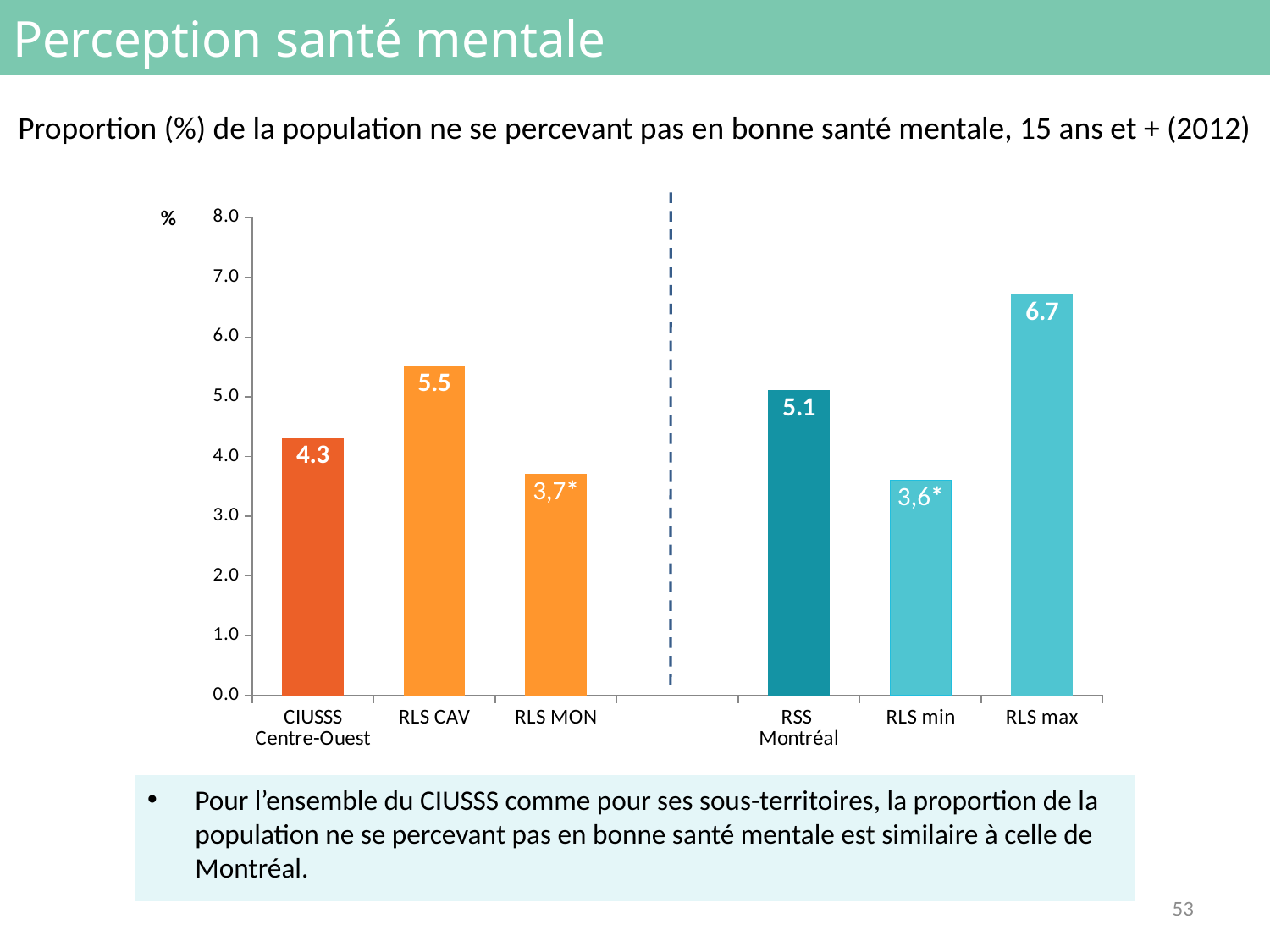
What is the value for RLS max? 6.7 What data label is shown on the RLS MON bar? 3,7* What kind of chart is shown on the slide? bar chart What is the value for RLS CAV? 5.5 How many categories are shown on the x axis? 6 What is the difference between the values for RLS CAV and CIUSSS Centre-Ouest? 1.2 Which category has the highest value? RLS max What is the difference between the values for RLS max and RSS Montréal? 1.6 What is the value for CIUSSS Centre-Ouest? 4.3 Which is larger, the value for RLS CAV or the value for RSS Montréal? RLS CAV Which category has the lowest value? RLS min What is the value for RSS Montréal? 5.1